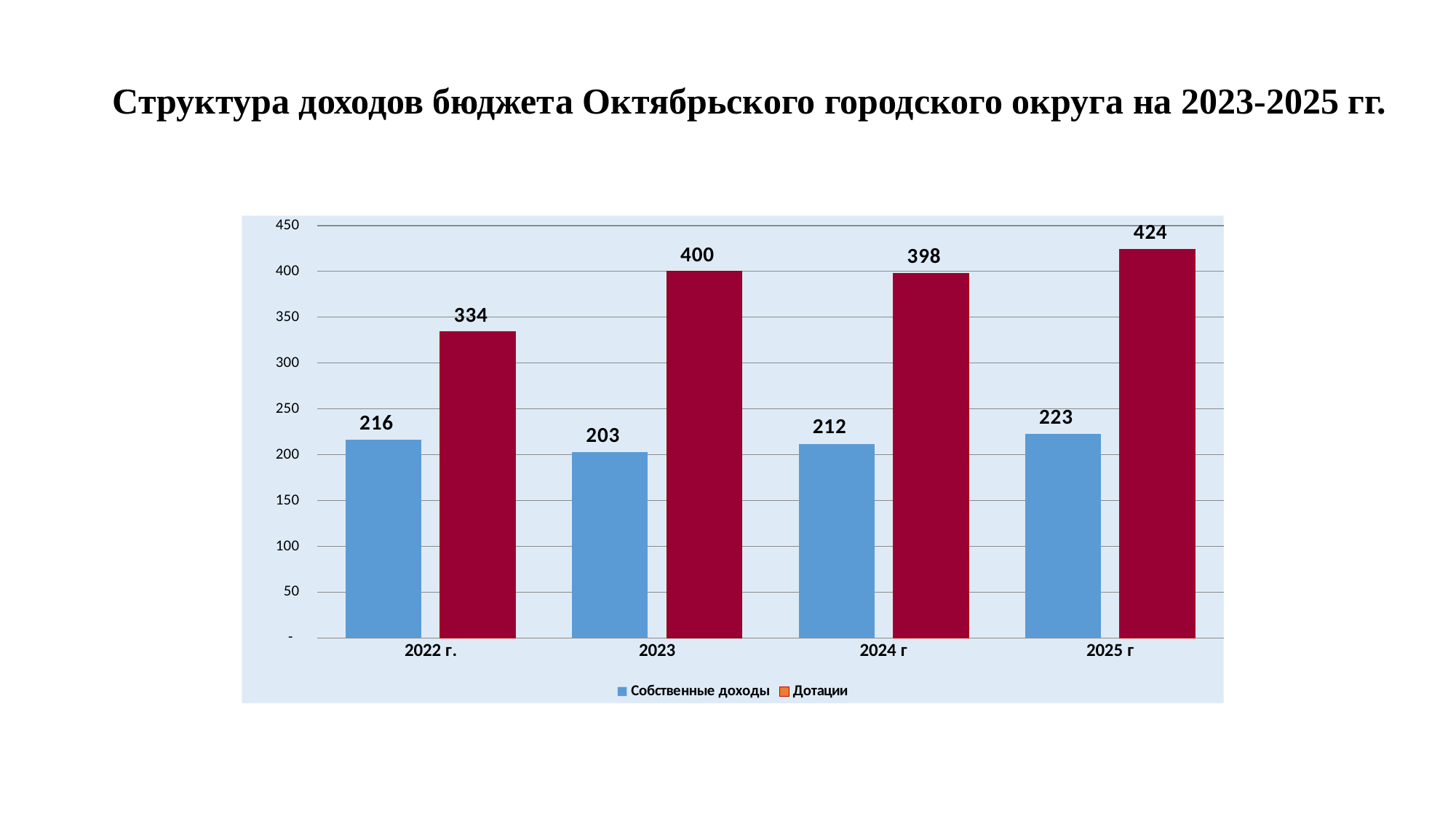
What is the difference between Дотации and Собственные доходы in 2024 г? 186 How many series does the legend list? 2 What is the value of Собственные доходы for 2022 г.? 216 What is the title of the slide? Структура доходов бюджета Октябрьского городского округа на 2023-2025 гг. In which year is Собственные доходы lowest? 2023 Which is larger in 2022 г.: Собственные доходы or Дотации? Дотации What kind of chart is shown on the slide? Bar chart Is the value of Дотации for 2022 г. greater or less than 300? greater What is the value of Дотации for 2025 г? 424 In which year is Дотации highest? 2025 г What is the value of Дотации for 2023? 400 How many years are shown on the x axis? 4